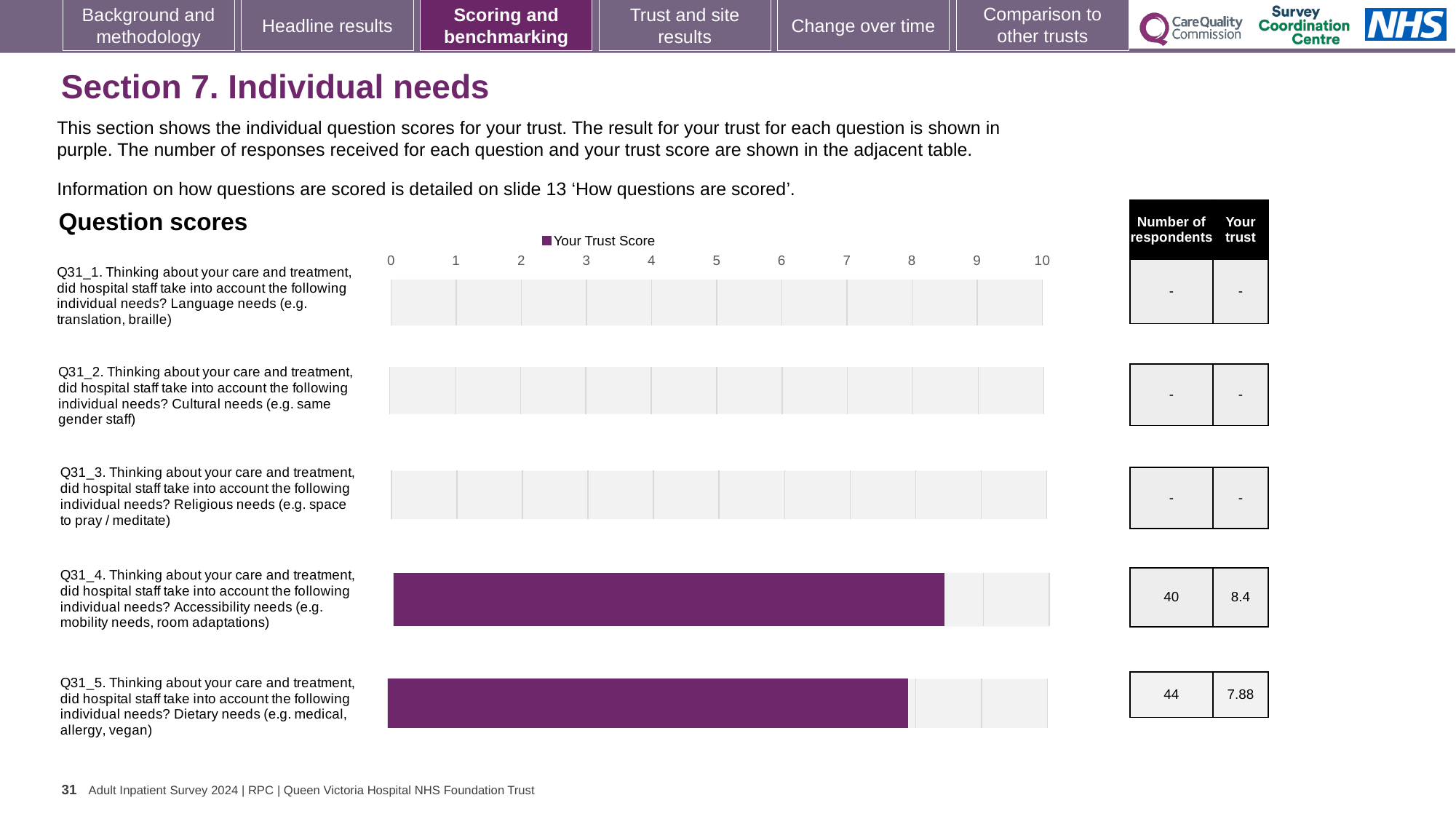
What is the trust score for Q31_5 (Dietary needs)? 7.88 How many series does the chart legend list? 1 Which has a higher trust score, Q31_4 (Accessibility needs) or Q31_5 (Dietary needs)? Q31_4 (Accessibility needs) Which question has the highest trust score shown on the chart? Q31_4 (Accessibility needs) What is the name of the series shown in the chart legend? Your Trust Score How many respondents answered Q31_4 (Accessibility needs)? 40 How many questions are listed on the chart? 5 What type of chart is used to show the question scores? Bar chart Is the trust score for Q31_5 (Dietary needs) greater or less than 7? greater What is the trust score for Q31_4 (Accessibility needs)? 8.4 How many respondents answered Q31_5 (Dietary needs)? 44 What is the difference between the trust scores for Q31_4 and Q31_5? 0.52